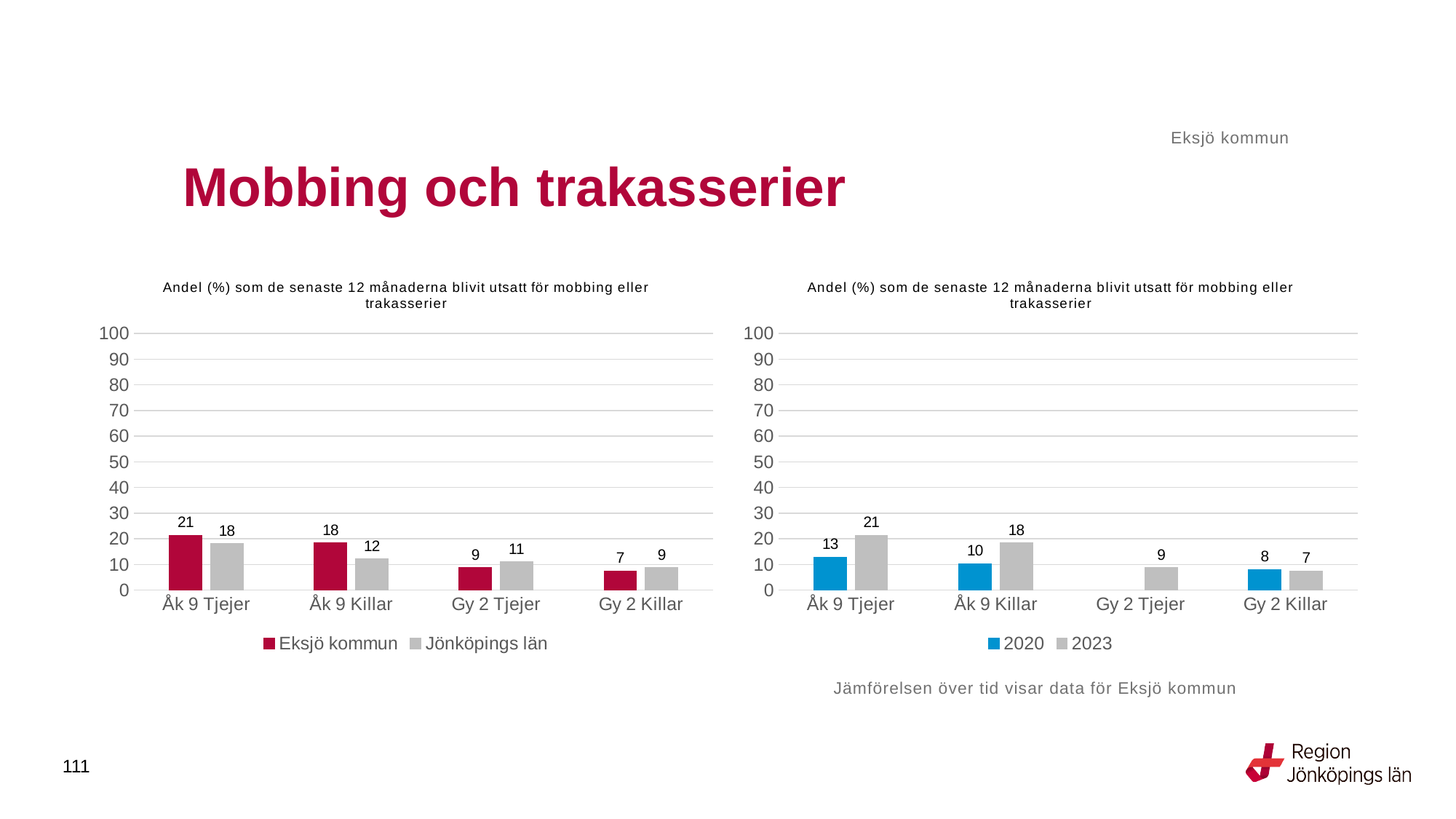
In the left chart, which category has the highest Eksjö kommun value? Åk 9 Tjejer In the left chart, what is the value for Eksjö kommun for Åk 9 Tjejer? 21 How many series does the legend of the right chart list? 2 What kind of chart is the left chart? Bar chart In the right chart, what is the 2023 value for Gy 2 Tjejer? 9 In the left chart, what is the difference between Eksjö kommun and Jönköpings län for Åk 9 Killar? 6 In the right chart, what is the 2020 value for Åk 9 Tjejer? 13 In the left chart, what is the value for Jönköpings län for Åk 9 Killar? 12 In the right chart, which is larger for Gy 2 Killar, the 2020 value or the 2023 value? 2020 How many categories are shown on the x axis of the left chart? 4 In the right chart, what is the difference between the 2023 and 2020 values for Åk 9 Tjejer? 8 In the left chart, which category has the lowest Jönköpings län value? Gy 2 Killar